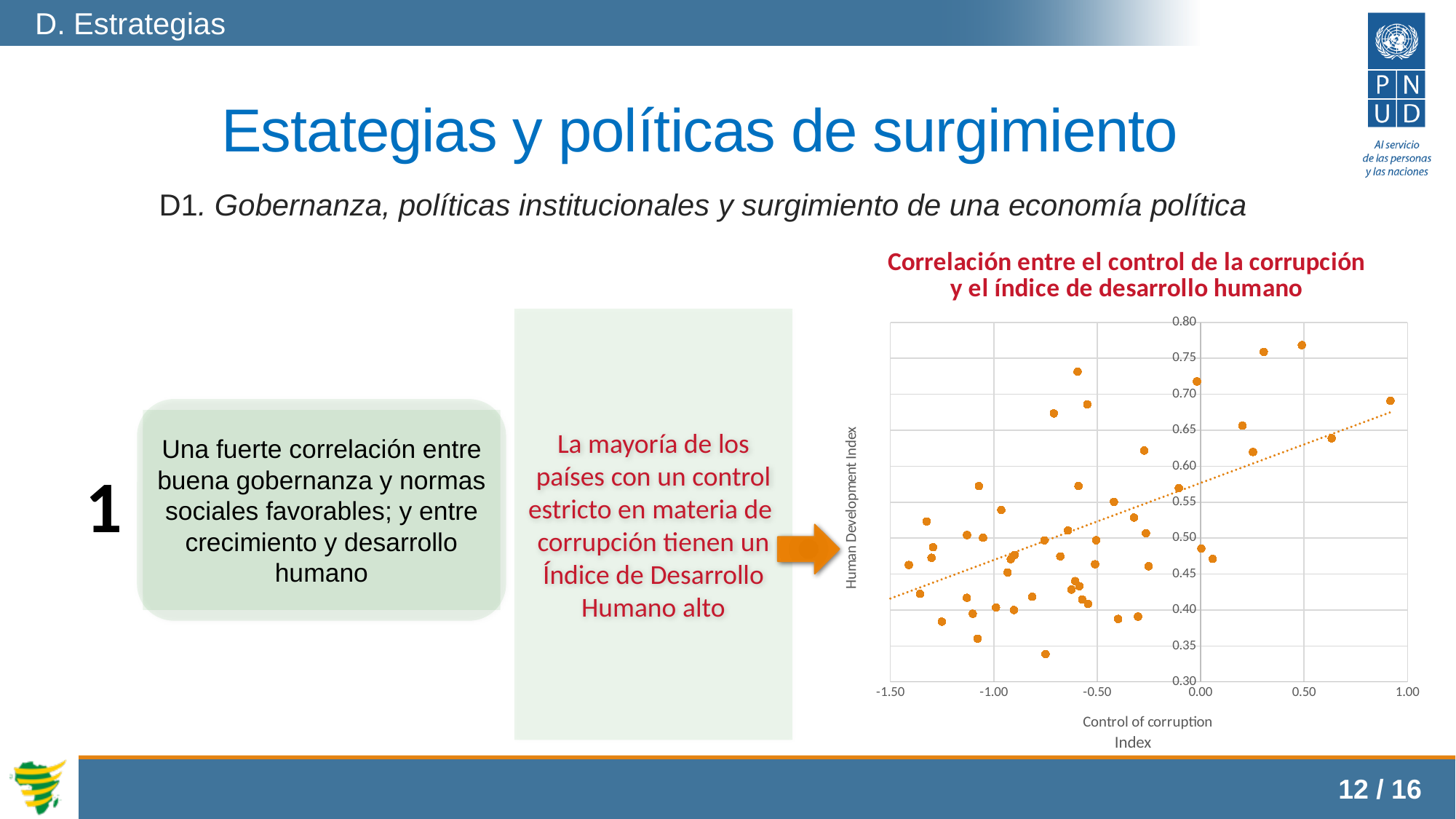
Is the Human Development Index of the lowest point in the chart greater or less than 0.35? less What is the label of the vertical axis of the chart? Human Development Index What kind of chart is shown on the slide? scatter chart Does the dotted trend line in the chart slope upward or downward from left to right? upward As the Control of corruption Index increases along the x axis, does the Human Development Index generally rise or fall? rise Is the Human Development Index of the highest point in the chart greater or less than 0.75? greater Is the Control of corruption Index of the rightmost point in the chart greater or less than 0.50? greater Are more of the plotted points on the negative or the positive side of the Control of corruption Index (0.00)? negative What is the title of the chart? Correlación entre el control de la corrupción y el índice de desarrollo humano